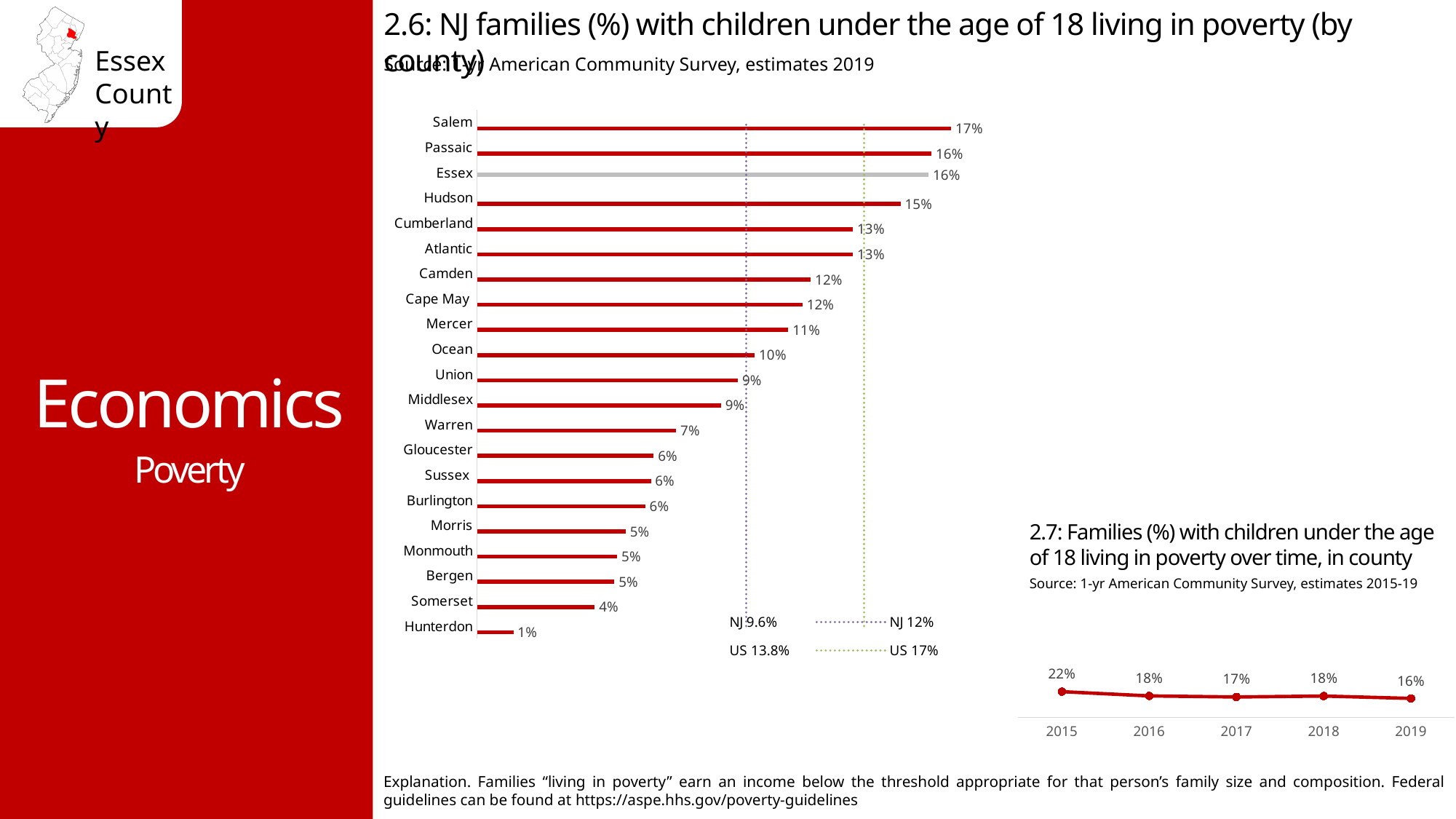
What kind of chart is chart 2.7? Line chart In chart 2.6, what is the value for Essex? 16% In chart 2.6, which has a larger value, Mercer or Warren? Mercer In chart 2.6, which county has the highest value? Salem In chart 2.6, what is the difference between the values for Salem and Hudson? 2% In chart 2.6, what is the value for Somerset? 4% In chart 2.7, what is the difference between the values for 2015 and 2019? 6% In chart 2.6, which county has the lowest value? Hunterdon In chart 2.7, how many years are plotted? 5 In chart 2.7, what is the value for 2015? 22% In chart 2.6, what is the value for Hunterdon? 1% In chart 2.6, how many counties are shown? 21